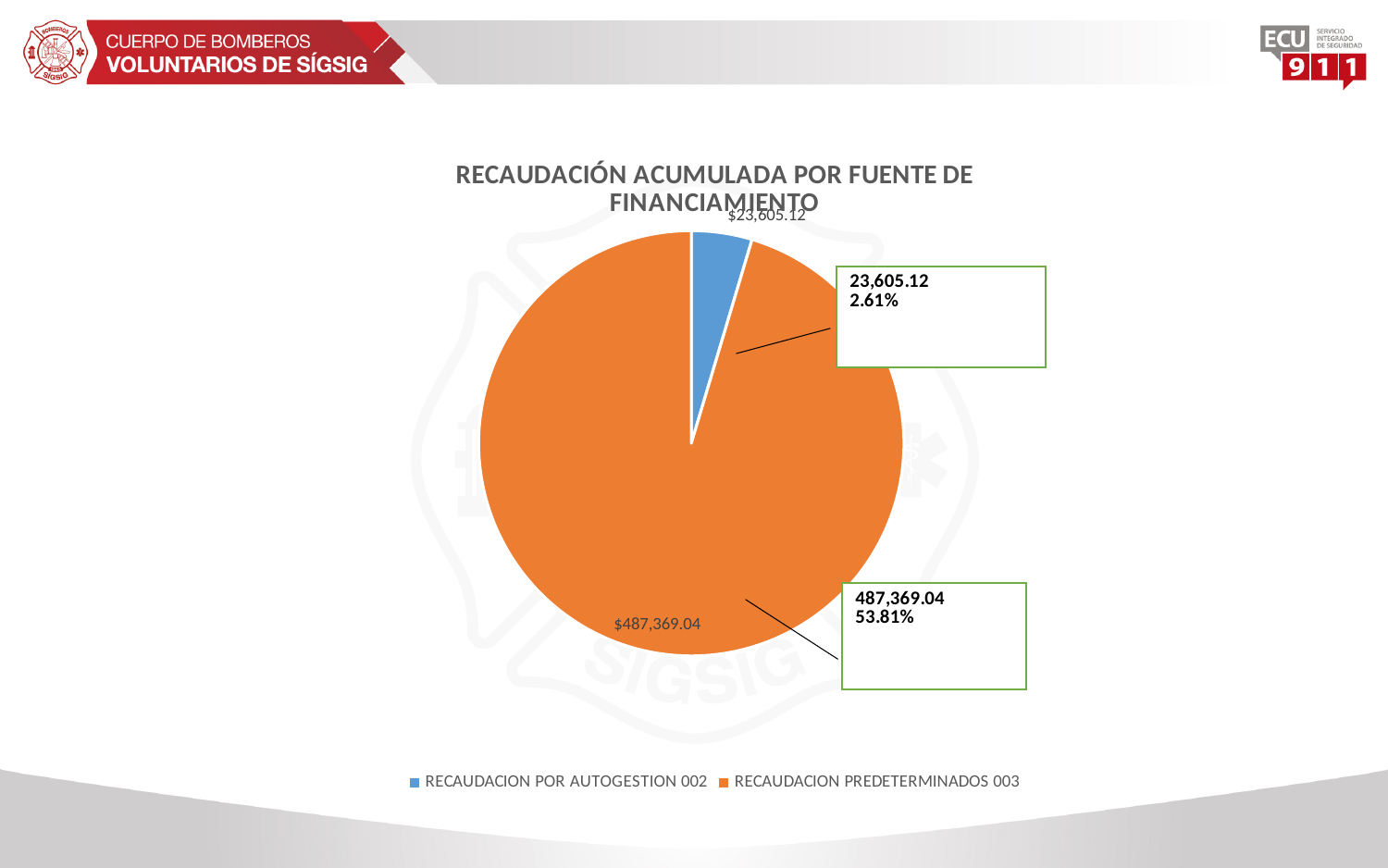
What percentage is printed in the callout box next to the 23,605.12 slice? 2.61% What kind of chart is shown on the slide? pie chart How many entries does the legend list? 2 What is the difference between the value for RECAUDACION PREDETERMINADOS 003 and the value for RECAUDACION POR AUTOGESTION 002? $463,763.92 What is the value for RECAUDACION POR AUTOGESTION 002? $23,605.12 What is the value for RECAUDACION PREDETERMINADOS 003? $487,369.04 What is the title of the chart? RECAUDACIÓN ACUMULADA POR FUENTE DE FINANCIAMIENTO How many slices does the pie chart have? 2 Which source has the largest slice of the pie? RECAUDACION PREDETERMINADOS 003 Which is larger, the value for RECAUDACION POR AUTOGESTION 002 or for RECAUDACION PREDETERMINADOS 003? RECAUDACION PREDETERMINADOS 003 Which source has the smallest slice of the pie? RECAUDACION POR AUTOGESTION 002 What colour is the slice for RECAUDACION PREDETERMINADOS 003? orange